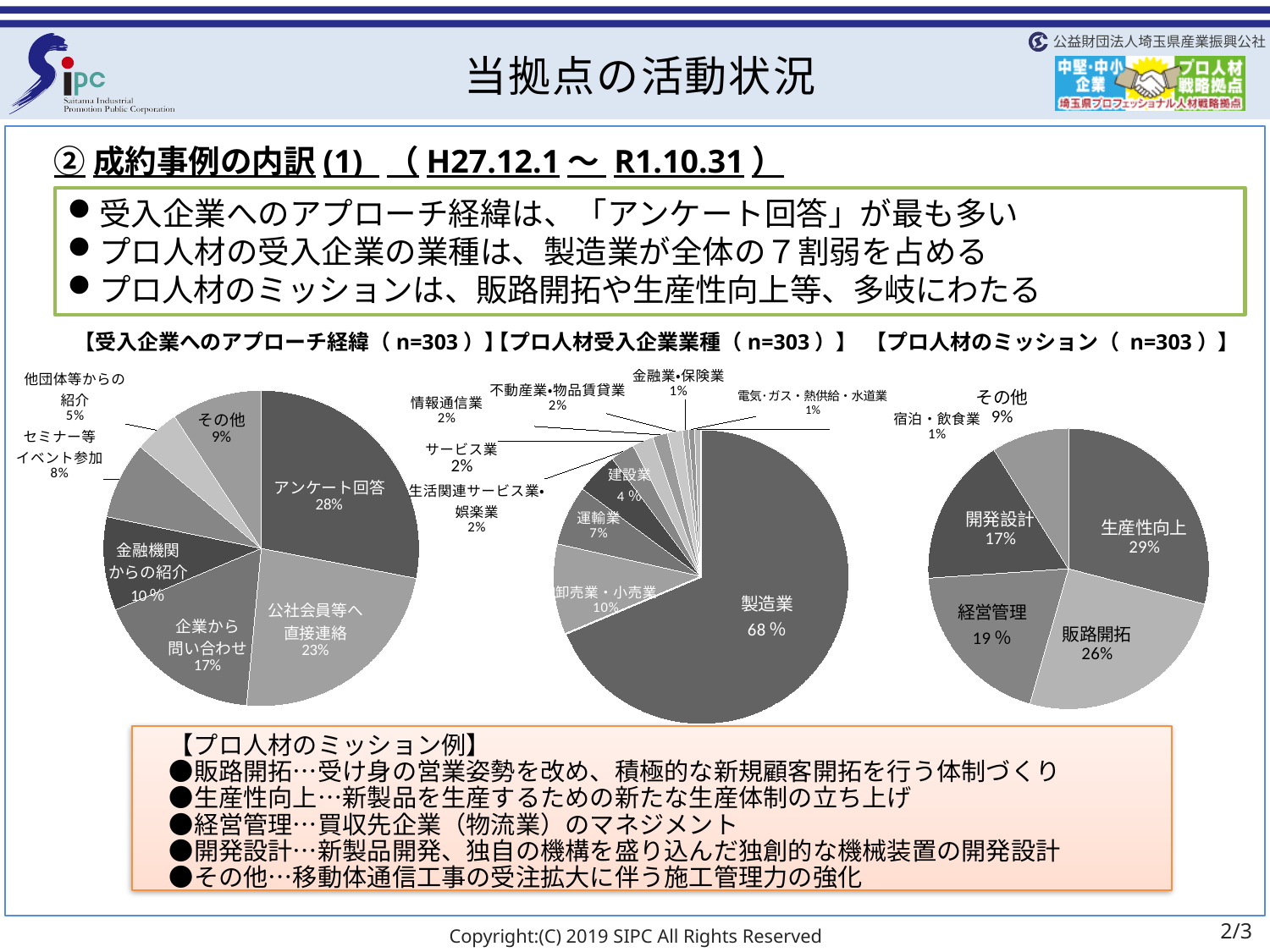
【プロ人材受入企業業種】の円グラフで、「建設業」の割合はいくつですか？ 4% 【プロ人材のミッション】の円グラフで、最も割合が大きい項目はどれですか？ 生産性向上 【受入企業へのアプローチ経緯】の円グラフには、いくつの項目がありますか？ 7 【プロ人材のミッション】の円グラフで、「販路開拓」の割合はいくつですか？ 26% このスライドの3つのグラフはどの種類のグラフですか？ 円グラフ 【プロ人材のミッション】の円グラフで、「経営管理」と「開発設計」の割合の差はいくつですか？ 2% 【受入企業へのアプローチ経緯】の円グラフで、「公社会員等へ直接連絡」と「企業から問い合わせ」の割合の差はいくつですか？ 6% 【受入企業へのアプローチ経緯】の円グラフで、「アンケート回答」の割合はいくつですか？ 28% 【受入企業へのアプローチ経緯】の円グラフで、最も割合が大きい項目はどれですか？ アンケート回答 【受入企業へのアプローチ経緯】の円グラフで、最も割合が小さい項目はどれですか？ 他団体等からの紹介 【プロ人材受入企業業種】の円グラフで、「製造業」の割合はいくつですか？ 68% 【プロ人材受入企業業種】の円グラフで、「卸売業・小売業」と「運輸業」ではどちらの割合が大きいですか？ 卸売業・小売業